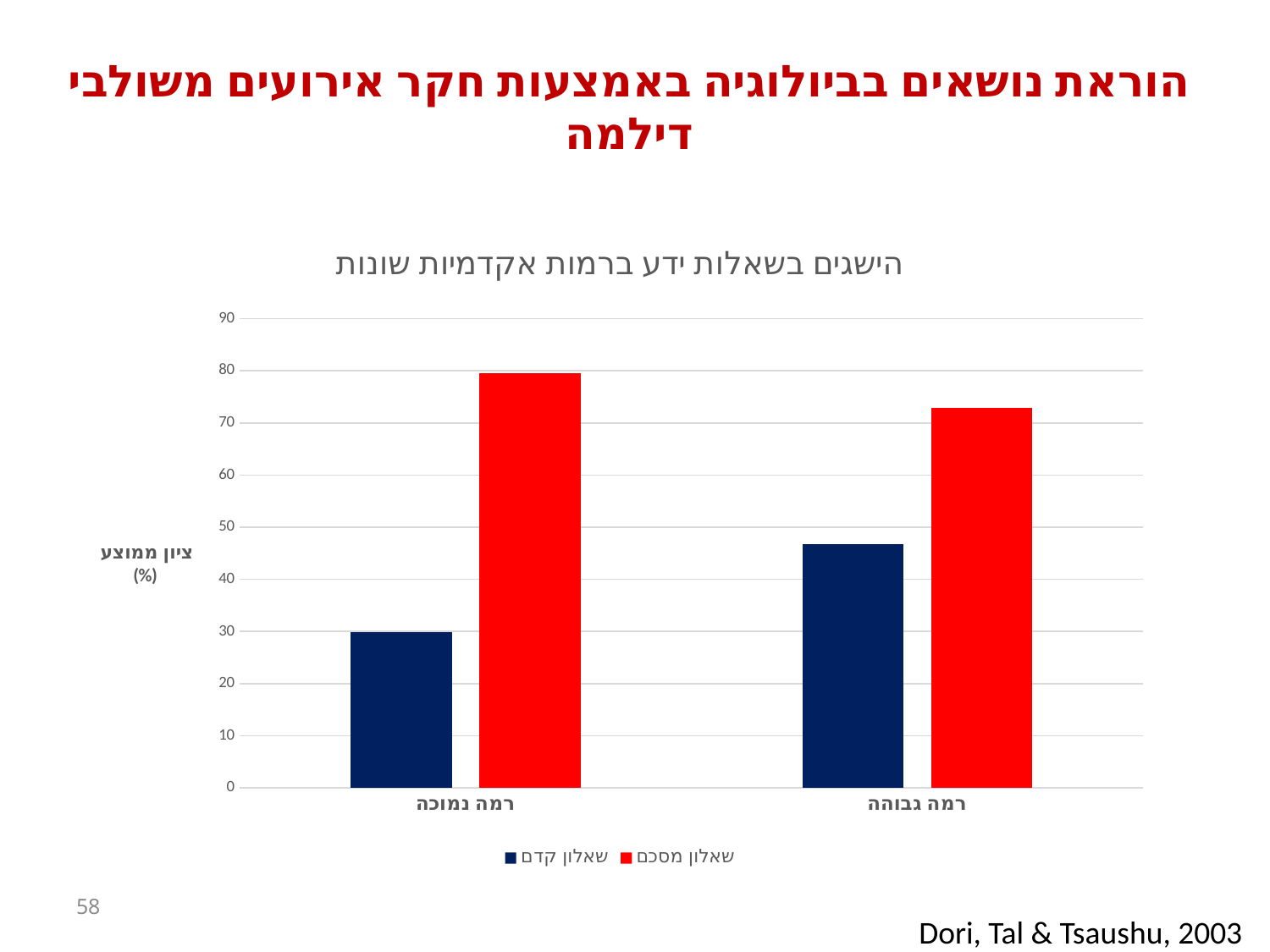
Does the value of שאלון קדם rise or fall from רמה נמוכה to רמה גבוהה? rise How many series does the legend list? 2 For רמה נמוכה, which is larger: שאלון קדם or שאלון מסכם? שאלון מסכם Is the value of שאלון מסכם for רמה גבוהה greater or less than 80? less Which bar is the shortest in the chart? שאלון קדם for רמה נמוכה What is the title of the chart? הישגים בשאלות ידע ברמות אקדמיות שונות How many categories are shown on the x axis? 2 Which bar is the tallest in the chart? שאלון מסכם for רמה נמוכה Which series is shown in red? שאלון מסכם Is the value of שאלון קדם for רמה גבוהה greater or less than 40? greater For רמה גבוהה, which is larger: שאלון קדם or שאלון מסכם? שאלון מסכם What type of chart is shown on the slide? bar chart